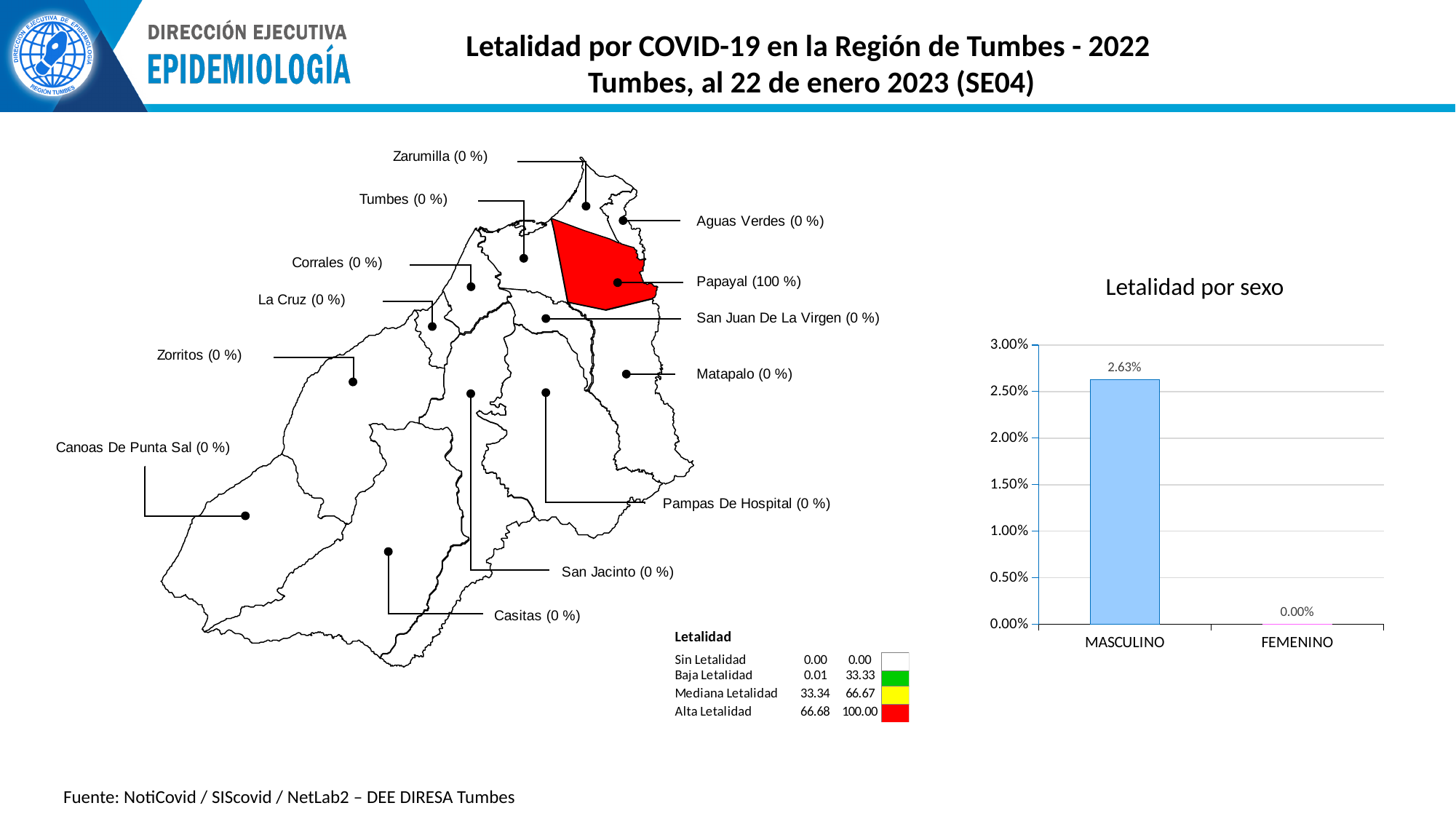
In the 'Letalidad por sexo' chart, which category has the lowest value? FEMENINO In the 'Letalidad por sexo' chart, what is the value for FEMENINO? 0.00% In the 'Letalidad por sexo' chart, is the value for MASCULINO greater or less than 2.50%? greater How many categories are shown in the 'Letalidad por sexo' chart? 2 In the 'Letalidad por sexo' chart, which category has the highest value? MASCULINO In the 'Letalidad por sexo' chart, is the value for MASCULINO greater or less than 3.00%? less What is the title of the chart on the right side of the slide? Letalidad por sexo In the 'Letalidad por sexo' chart, what is the difference between the MASCULINO and FEMENINO values? 2.63% What kind of chart is 'Letalidad por sexo'? bar chart On the map, what lethality percentage is shown for Papayal? 100 % On the map, which district is shaded red (Alta Letalidad)? Papayal In the 'Letalidad por sexo' chart, what is the value for MASCULINO? 2.63%